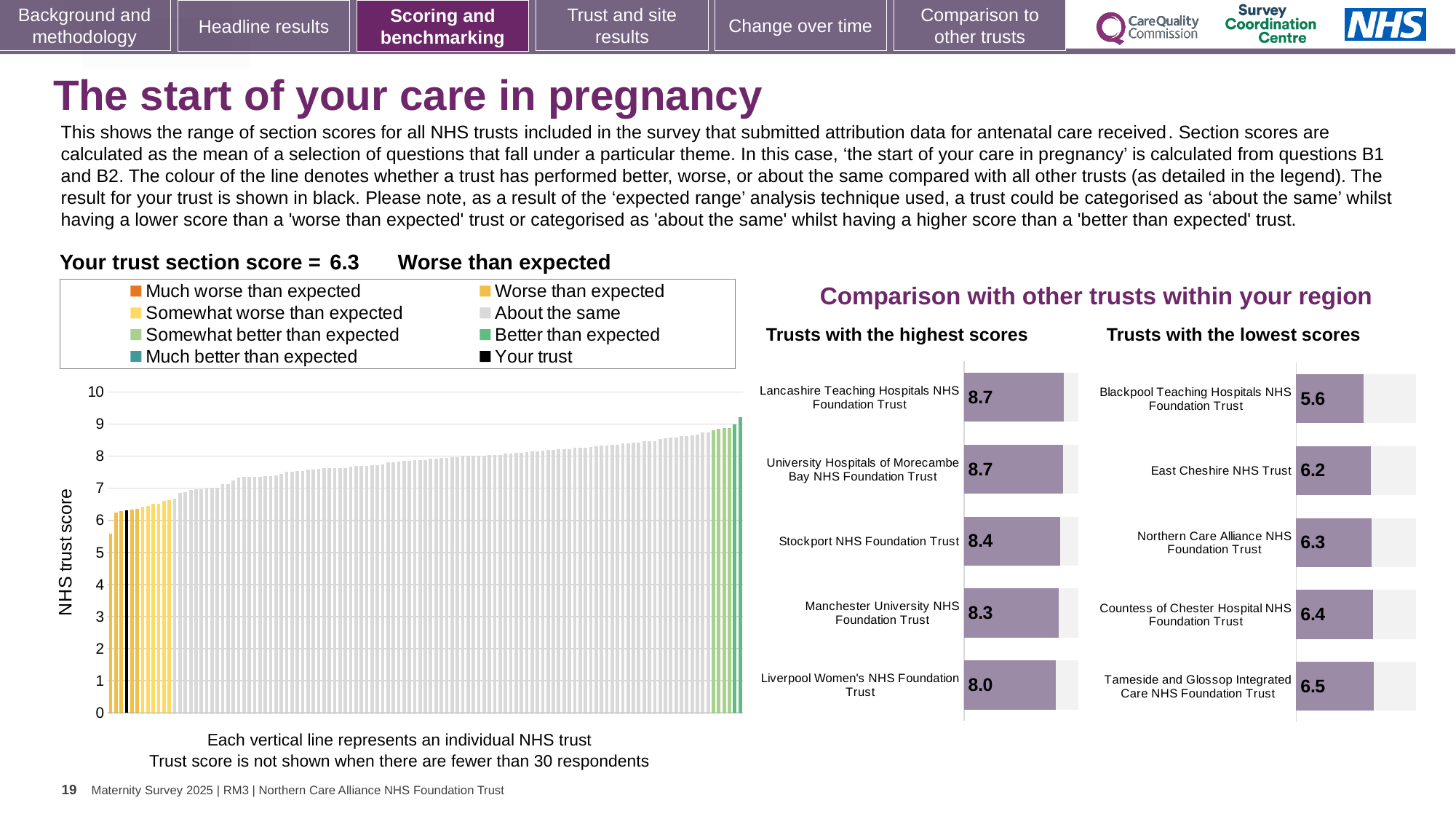
What is the section score for your trust shown on the slide? 6.3 In the 'Trusts with the lowest scores' chart, what is the difference between the scores of Tameside and Glossop Integrated Care NHS Foundation Trust and Blackpool Teaching Hospitals NHS Foundation Trust? 0.9 In the 'Trusts with the highest scores' chart, which has the higher score: Manchester University NHS Foundation Trust or Stockport NHS Foundation Trust? Stockport NHS Foundation Trust In the 'Trusts with the highest scores' chart, what is the difference between the scores of Lancashire Teaching Hospitals NHS Foundation Trust and Liverpool Women's NHS Foundation Trust? 0.7 In the 'Trusts with the lowest scores' chart, what is the score for Blackpool Teaching Hospitals NHS Foundation Trust? 5.6 In the 'Trusts with the highest scores' chart, what is the score for Stockport NHS Foundation Trust? 8.4 What kind of chart is the large chart on the left showing NHS trust scores? Bar chart In the 'Trusts with the highest scores' chart, which trust has the lowest score? Liverpool Women's NHS Foundation Trust In the large chart on the left, do the trust scores rise or fall from left to right? Rise In the 'Trusts with the lowest scores' chart, which trust has the highest score? Tameside and Glossop Integrated Care NHS Foundation Trust How many entries does the legend of the left-hand chart list? 8 How many trusts are shown in the 'Trusts with the lowest scores' chart? 5